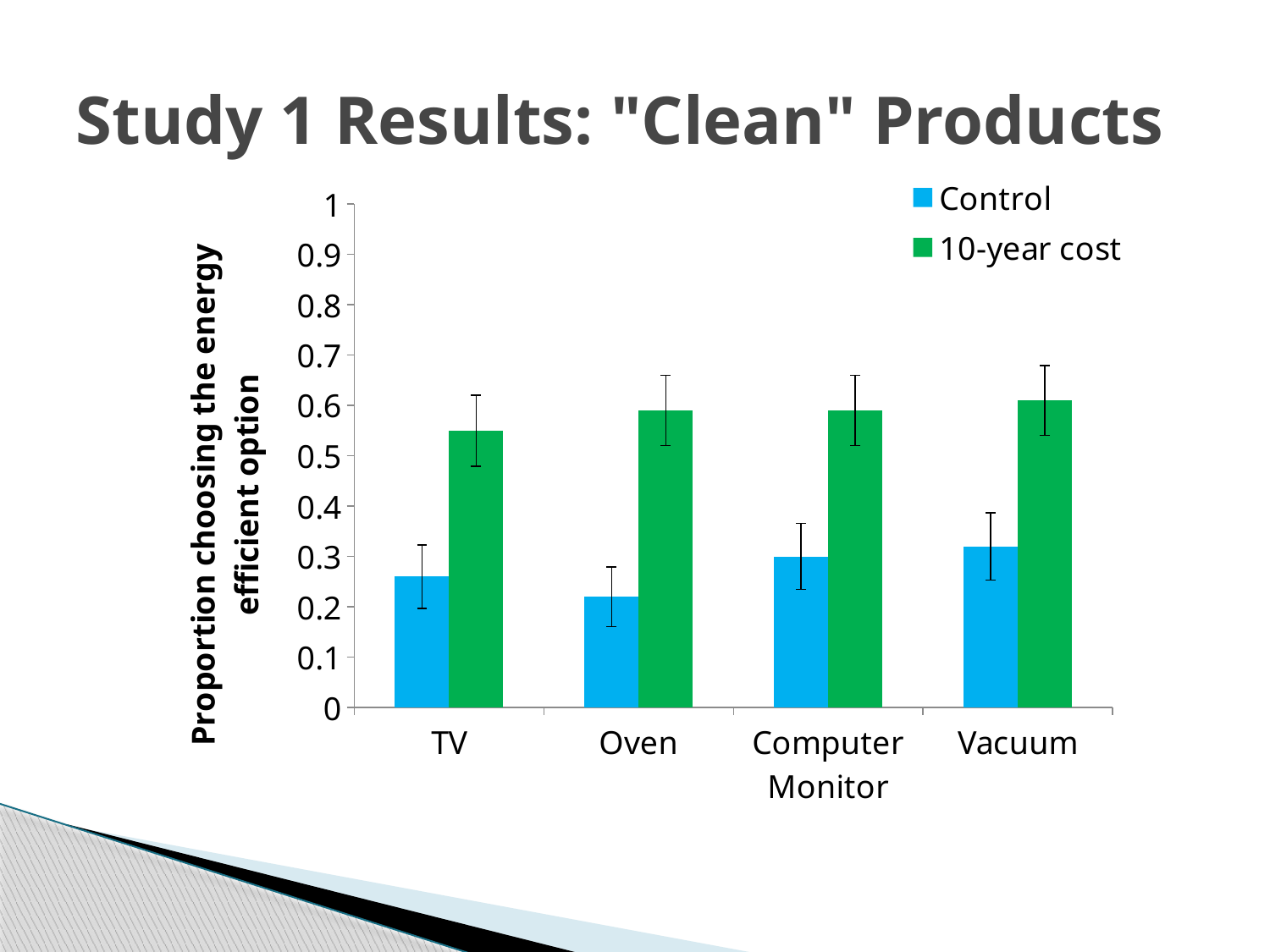
Is the 10-year cost value for Oven greater or less than 0.5? greater Which product has the lowest 10-year cost value? TV Is the Control value for TV greater or less than 0.3? less Is the 10-year cost value for Vacuum greater or less than 0.5? greater How many product categories are shown on the x axis? 4 Which product has the lowest Control value? Oven For TV, which is larger: the Control value or the 10-year cost value? 10-year cost How many series does the legend list? 2 What kind of chart is shown on the slide? bar chart What is the label on the vertical axis? Proportion choosing the energy efficient option